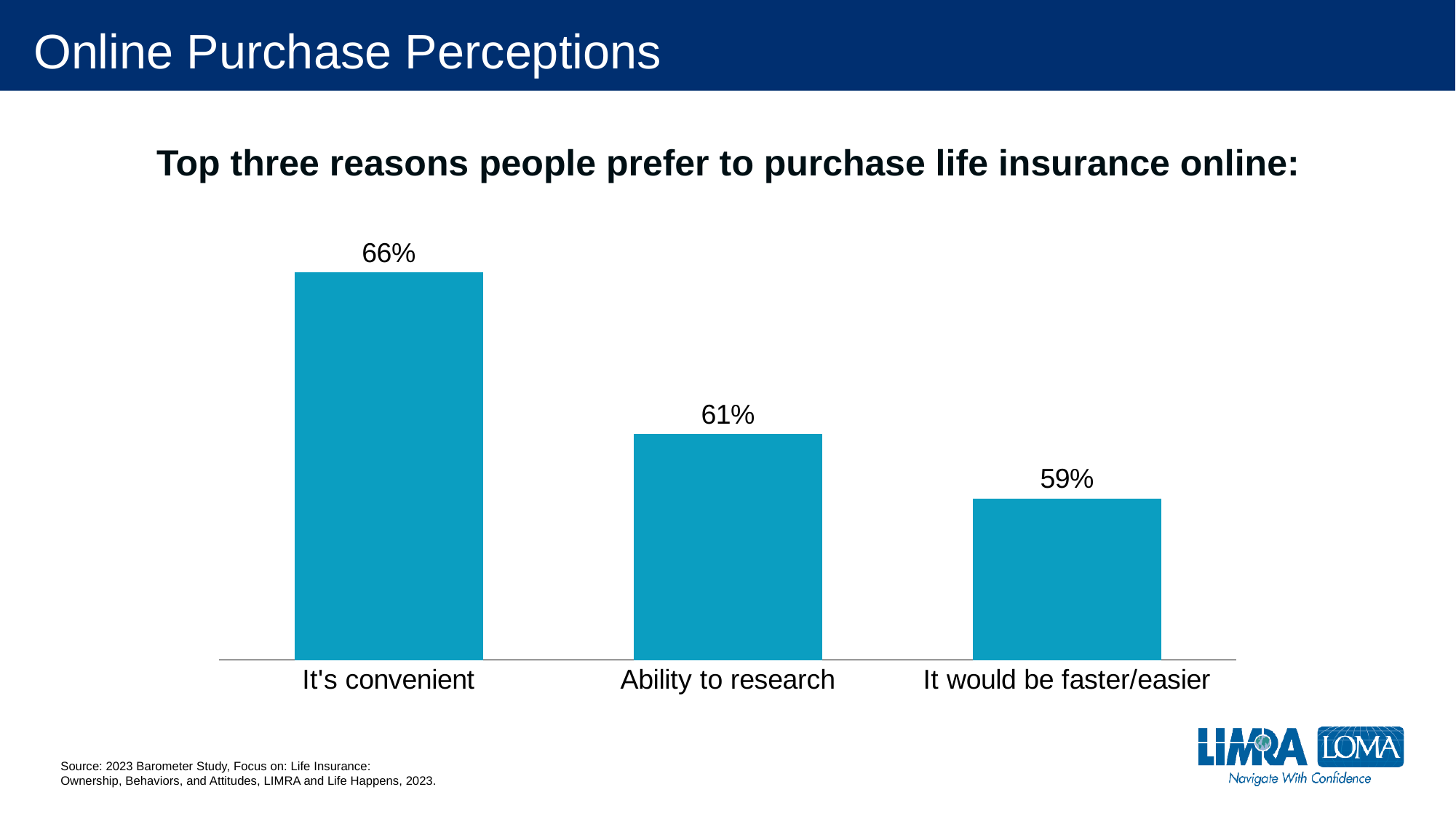
What is the value shown for "Ability to research"? 61% What percentage of people cite "It's convenient" as a reason to prefer purchasing life insurance online? 66% What is the difference in percentage points between "It's convenient" and "It would be faster/easier"? 7 percentage points Which reason has the lowest percentage? It would be faster/easier What kind of chart is shown on the slide? Bar chart What is the value shown for "It would be faster/easier"? 59% What is the heading above the chart? Top three reasons people prefer to purchase life insurance online: How many reasons are shown in the chart? 3 What is the difference in percentage points between "Ability to research" and "It would be faster/easier"? 2 percentage points Which is larger, the value for "It's convenient" or the value for "Ability to research"? It's convenient Which reason has the highest percentage? It's convenient Do the values rise or fall from left to right across the chart? Fall